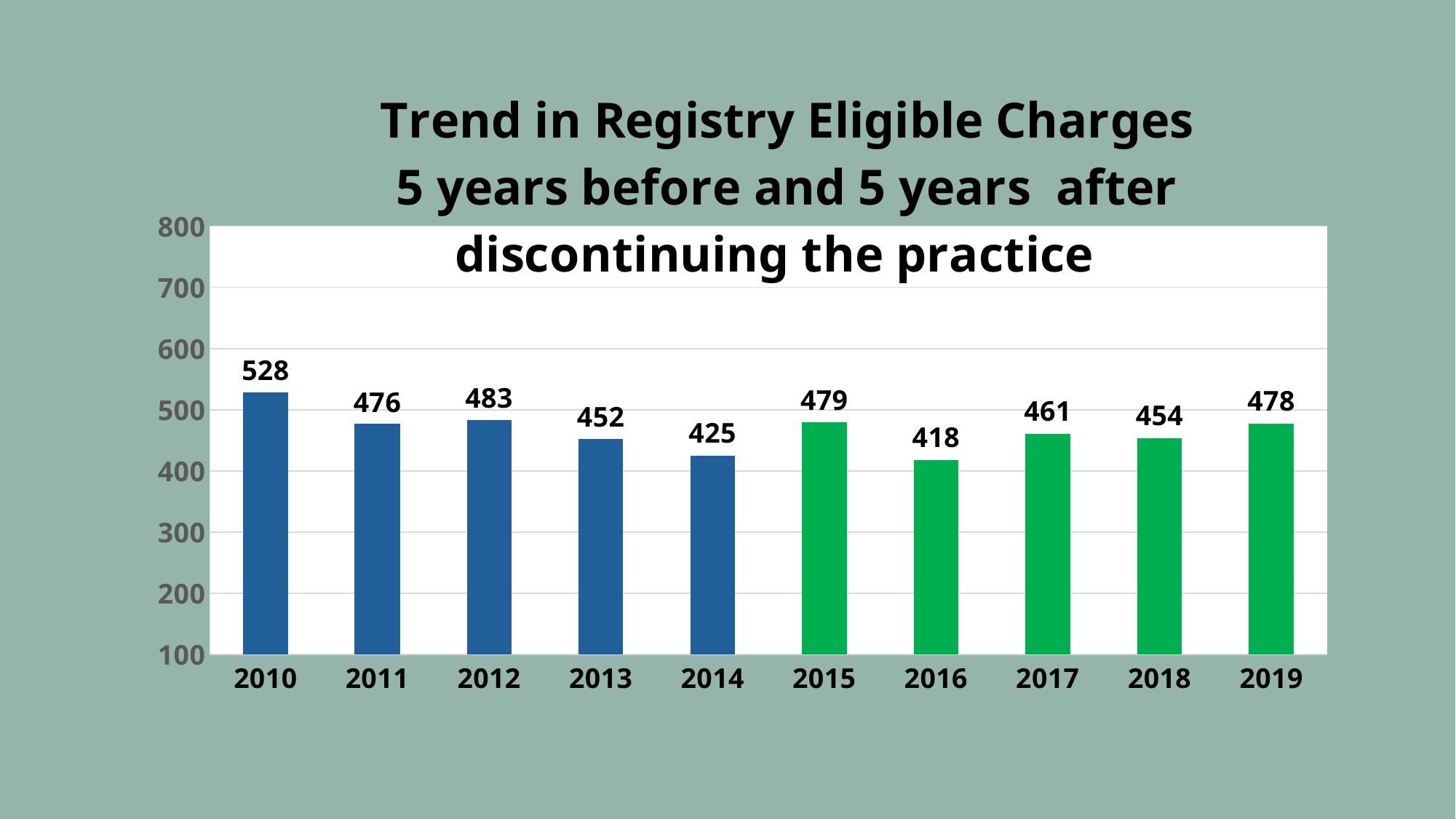
Do the values rise or fall from 2010 to 2014? fall Is the value for 2014 greater or less than 500? less What is the difference between the values for 2010 and 2014? 103 Which year has the lowest value? 2016 What is the value for 2010? 528 What is the value for 2016? 418 Which is larger, the value for 2012 or the value for 2013? 2012 What is the difference between the values for 2015 and 2016? 61 How many years are shown on the x axis? 10 What is the value for 2019? 478 Which year has the highest value? 2010 What kind of chart is shown on the slide? bar chart